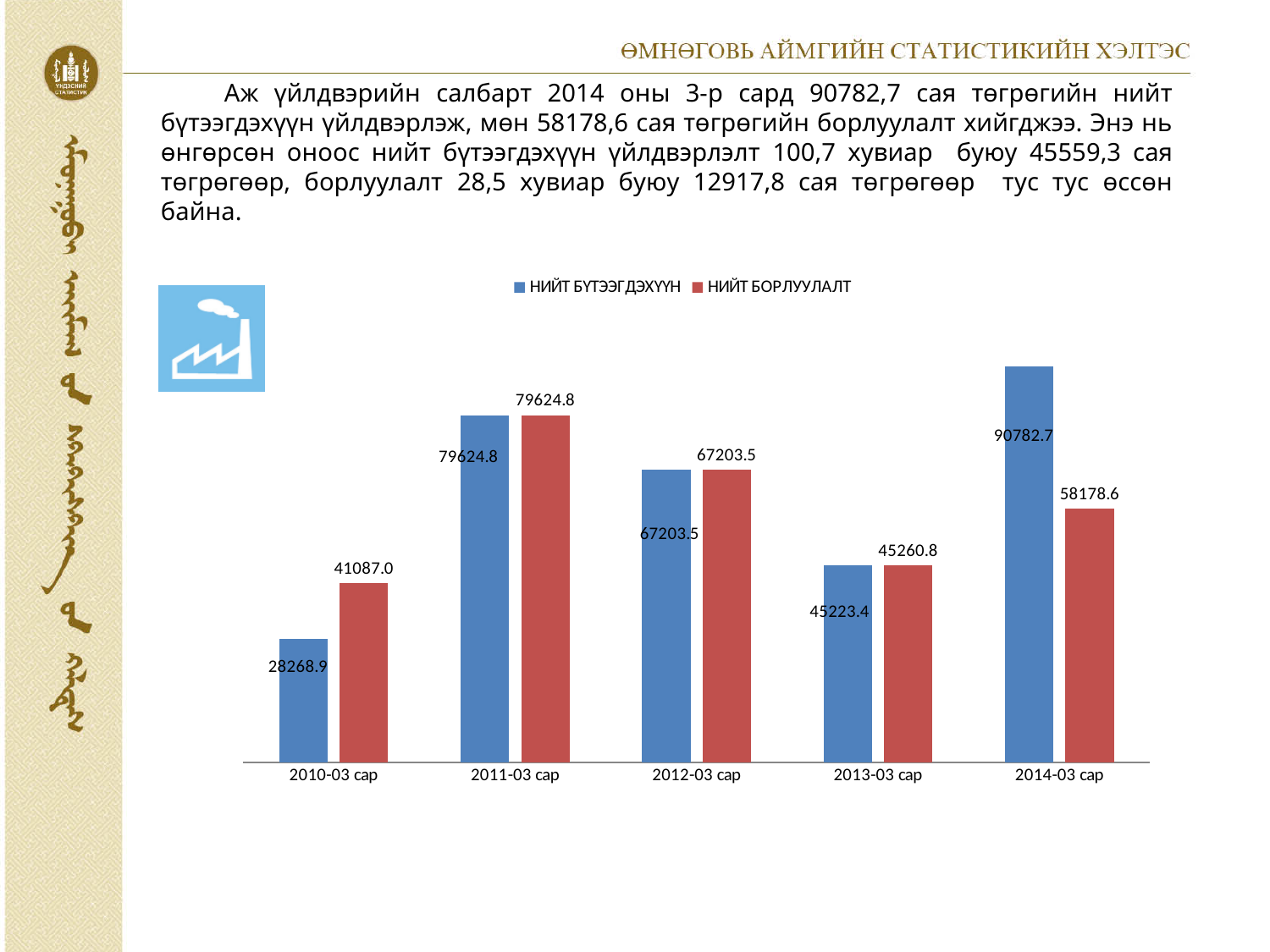
What is the value of НИЙТ БОРЛУУЛАЛТ for 2010-03 сар? 41087.0 What is the difference between НИЙТ БҮТЭЭГДЭХҮҮН and НИЙТ БОРЛУУЛАЛТ for 2014-03 сар? 32604.1 What is the value of НИЙТ БҮТЭЭГДЭХҮҮН for 2010-03 сар? 28268.9 How many periods are shown on the x axis of the chart? 5 In which period is НИЙТ БОРЛУУЛАЛТ the highest? 2011-03 сар In which period is НИЙТ БҮТЭЭГДЭХҮҮН the lowest? 2010-03 сар What is the value of НИЙТ БҮТЭЭГДЭХҮҮН for 2014-03 сар? 90782.7 How many series does the chart legend list? 2 In which period is НИЙТ БҮТЭЭГДЭХҮҮН the highest? 2014-03 сар What is the value of НИЙТ БОРЛУУЛАЛТ for 2014-03 сар? 58178.6 Which series has the larger value for 2014-03 сар? НИЙТ БҮТЭЭГДЭХҮҮН What is the value of НИЙТ БОРЛУУЛАЛТ for 2013-03 сар? 45260.8